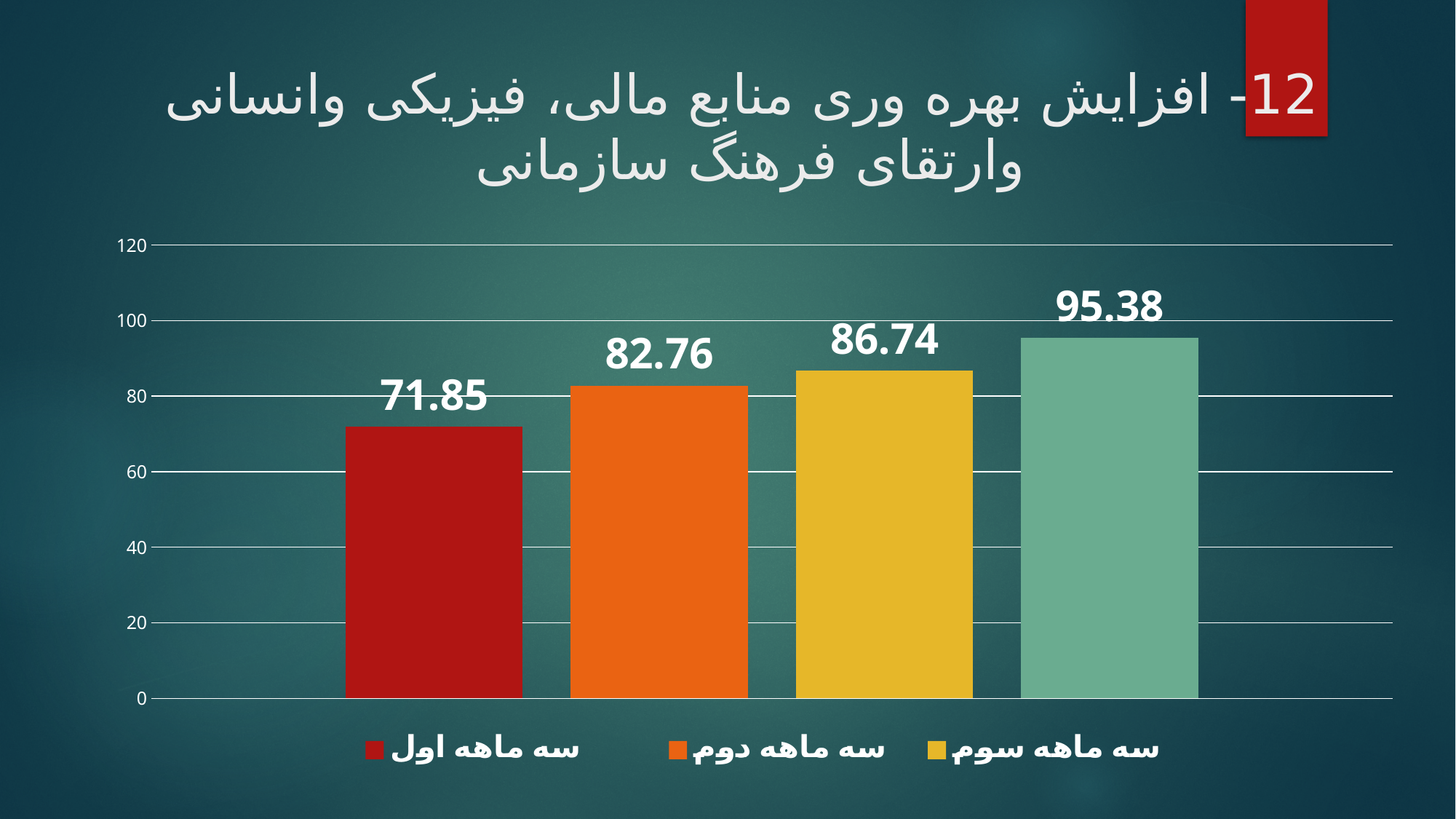
What is the value for سه ماهه سوم? 86.74 Which is larger, the value for سه ماهه سوم or the value for سه ماهه دوم? سه ماهه سوم What is the difference between the values for سه ماهه دوم and سه ماهه اول? 10.91 What is the value for سه ماهه اول? 71.85 What is the value for سه ماهه دوم? 82.76 Which legend category has the lowest value? سه ماهه اول What is the value shown on the rightmost (teal) bar? 95.38 How many entries does the legend list? 3 What is the highest value shown in the chart? 95.38 Is the value for سه ماهه اول greater or less than 80? less Do the bar values rise or fall from left to right? rise How many bars are plotted in the chart? 4